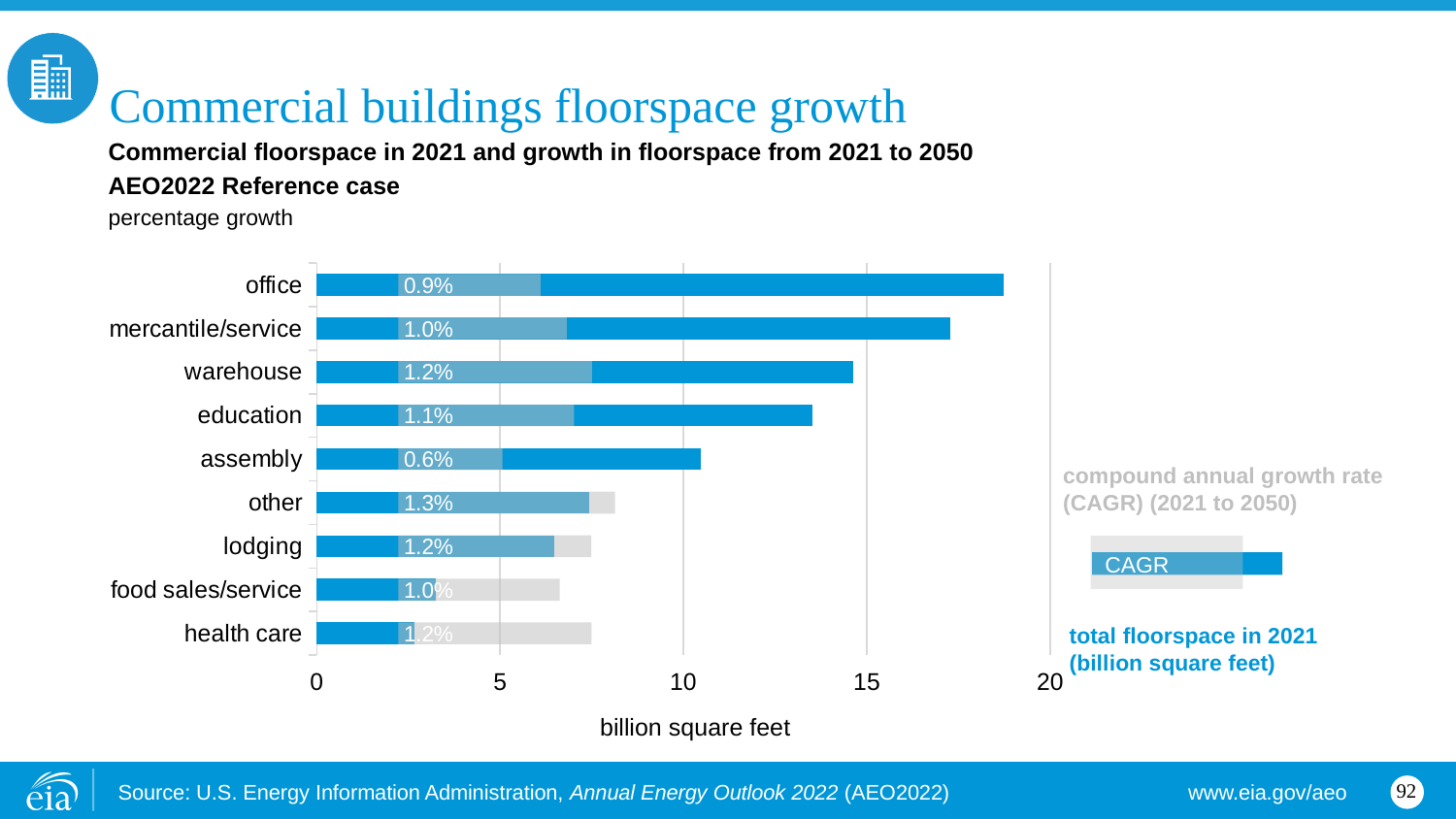
Is the total floorspace in 2021 for health care greater or less than 10 billion square feet? less What is the CAGR shown for assembly? 0.6% What is the CAGR shown for office floorspace? 0.9% Is the total floorspace in 2021 for office greater or less than 15 billion square feet? greater Which building type has the lowest CAGR label? assembly What is the difference between the CAGR for 'other' and the CAGR for assembly? 0.7 percentage points Which building type has the highest CAGR label? other What is the CAGR shown for the 'other' category? 1.3% Which has a larger total floorspace in 2021, office or health care? office What is the CAGR shown for education? 1.1% What kind of chart is shown on the slide? bar chart How many building types are listed on the chart? 9